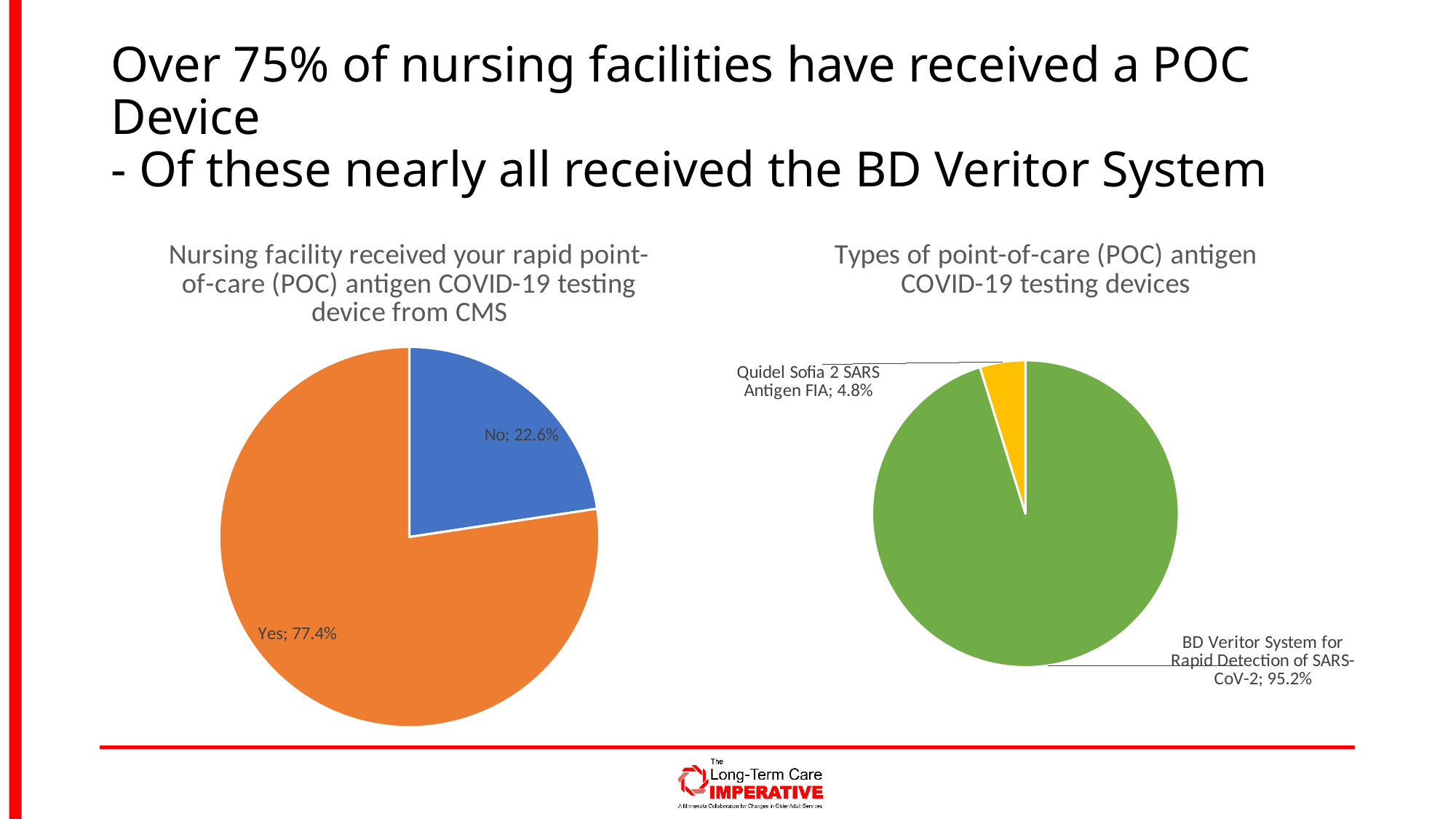
In the left chart (Nursing facility received your rapid POC device from CMS), what share of the pie is 'Yes'? 77.4% In the left chart (Nursing facility received your rapid POC device from CMS), what is the difference between the 'Yes' and 'No' shares? 54.8% In the right chart (Types of point-of-care (POC) antigen COVID-19 testing devices), which device has the smallest share? Quidel Sofia 2 SARS Antigen FIA In the right chart (Types of point-of-care (POC) antigen COVID-19 testing devices), which is larger: the BD Veritor System share or the Quidel Sofia 2 share? BD Veritor System for Rapid Detection of SARS-CoV-2 In the left chart (Nursing facility received your rapid POC device from CMS), how many slices does the pie have? 2 In the right chart (Types of point-of-care (POC) antigen COVID-19 testing devices), what is the difference between the BD Veritor System share and the Quidel Sofia 2 share? 90.4% What kind of chart is the left chart (Nursing facility received your rapid POC device from CMS)? Pie chart In the left chart (Nursing facility received your rapid POC device from CMS), what is the value for 'No'? 22.6% In the right chart (Types of point-of-care (POC) antigen COVID-19 testing devices), what share is the BD Veritor System for Rapid Detection of SARS-CoV-2? 95.2% In the left chart (Nursing facility received your rapid POC device from CMS), which category is the largest? Yes In the right chart (Types of point-of-care (POC) antigen COVID-19 testing devices), what colour is the BD Veritor System slice? Green In the right chart (Types of point-of-care (POC) antigen COVID-19 testing devices), what is the value for Quidel Sofia 2 SARS Antigen FIA? 4.8%